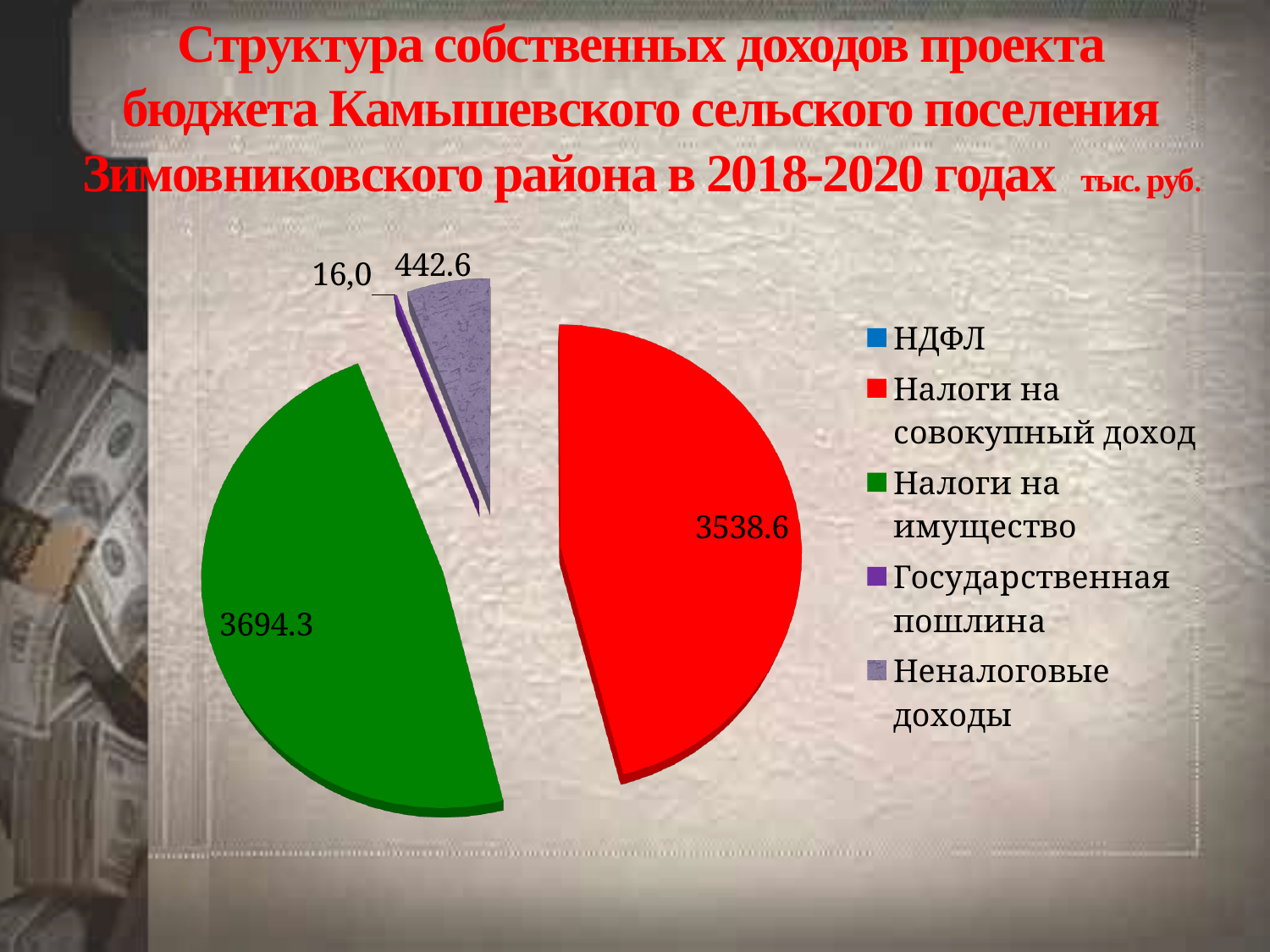
What is the difference between Неналоговые доходы and Государственная пошлина? 426.6 Which category has the highest labelled value? Налоги на имущество How many categories does the legend list? 5 What colour represents Налоги на имущество in the chart? green What is the value for Налоги на имущество? 3694.3 What is the difference between Налоги на имущество and Налоги на совокупный доход? 155.7 What kind of chart is shown on the slide? pie chart Which is larger, Налоги на имущество or Налоги на совокупный доход? Налоги на имущество Which is larger, Неналоговые доходы or Государственная пошлина? Неналоговые доходы What is the value for Неналоговые доходы? 442.6 What is the value for Государственная пошлина? 16,0 What is the value for Налоги на совокупный доход? 3538.6